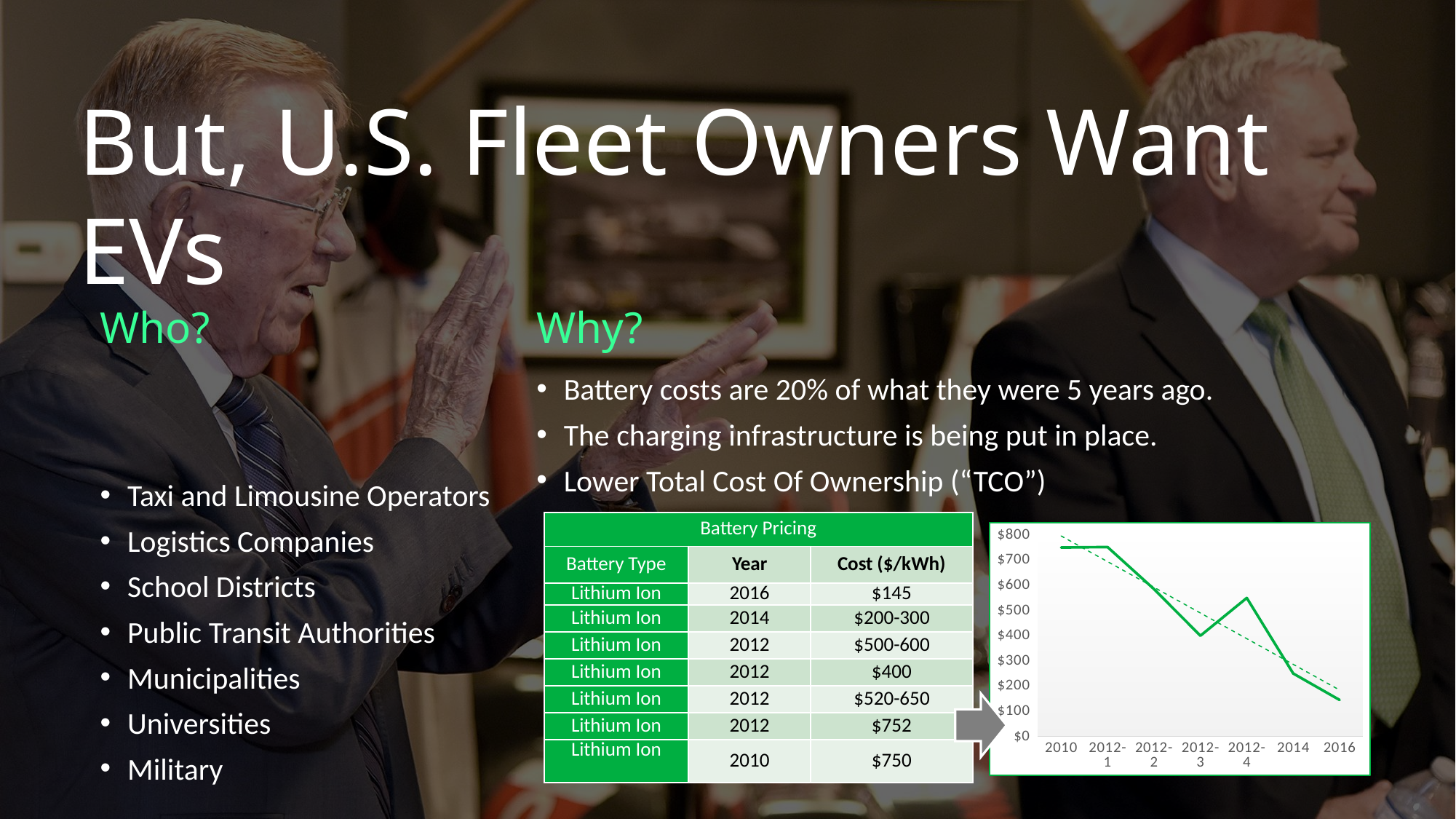
Is the value for 2012-3 in the line chart greater or less than $500? less In the line chart, which has the larger value: 2012-4 or 2014? 2012-4 Is the value for 2010 in the line chart greater or less than $700? greater Is the value for 2016 in the line chart greater or less than $200? less Do the values in the line chart generally rise or fall from 2010 to 2016? Fall What colour is the line plotted in the chart? Green Which x-axis category has the lowest value in the line chart? 2016 What kind of chart is shown on the slide? Line chart How many points are plotted along the x axis of the line chart? 7 In the line chart, which has the larger value: 2012-3 or 2012-4? 2012-4